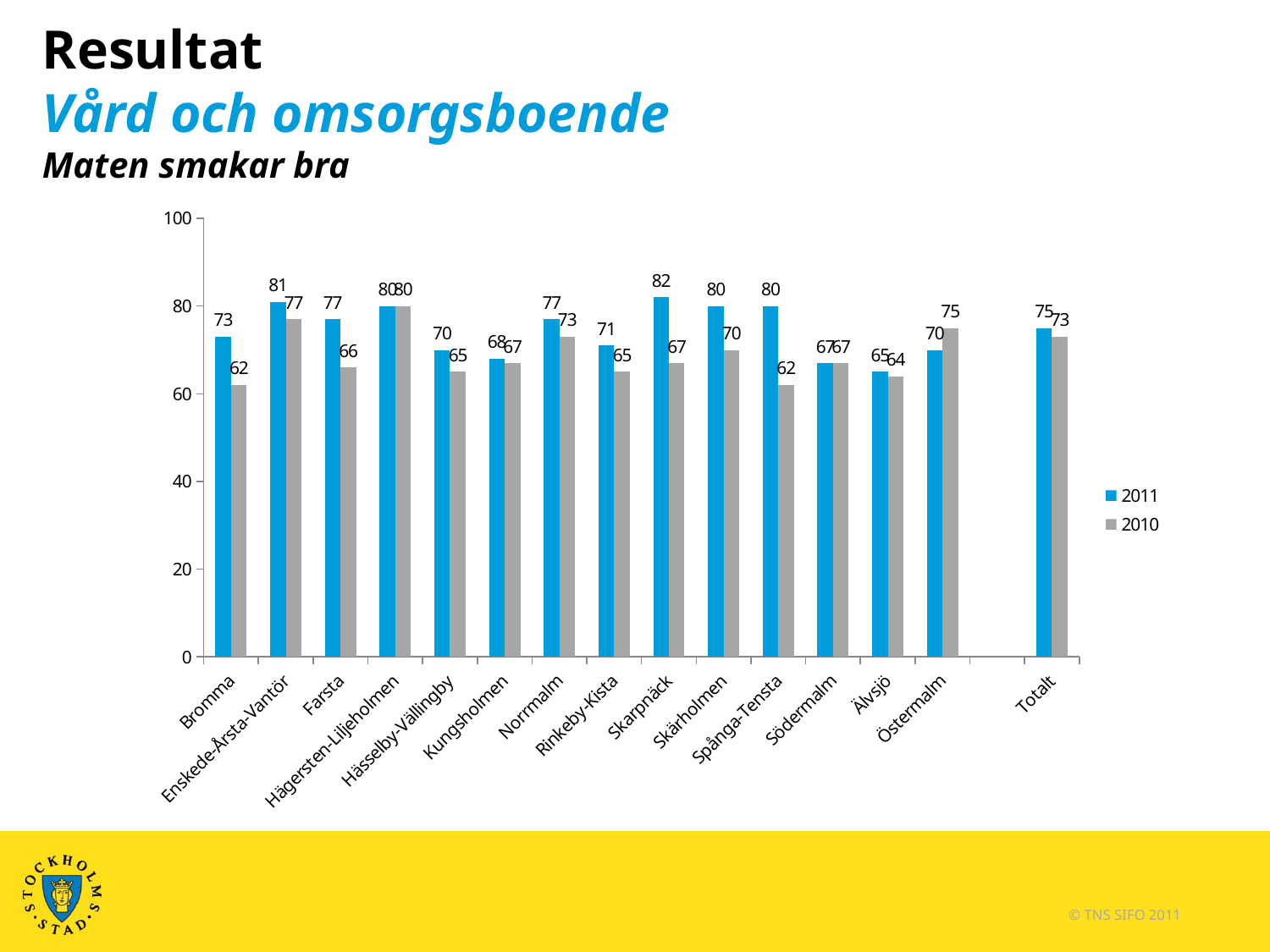
Which is larger for Östermalm, the 2011 value or the 2010 value? 2010 Which category has the highest 2011 value? Skarpnäck Which category has the highest 2010 value? Hägersten-Liljeholmen How many series does the legend list? 2 What is the 2011 value for Bromma? 73 How many categories are shown on the x axis? 15 What is the 2010 value for Farsta? 66 What is the difference between the 2011 and 2010 values for Spånga-Tensta? 18 Which category has the lowest 2011 value? Älvsjö What is the 2011 value for Totalt? 75 What kind of chart is shown on the slide? Bar chart What colour are the 2011 bars? Blue